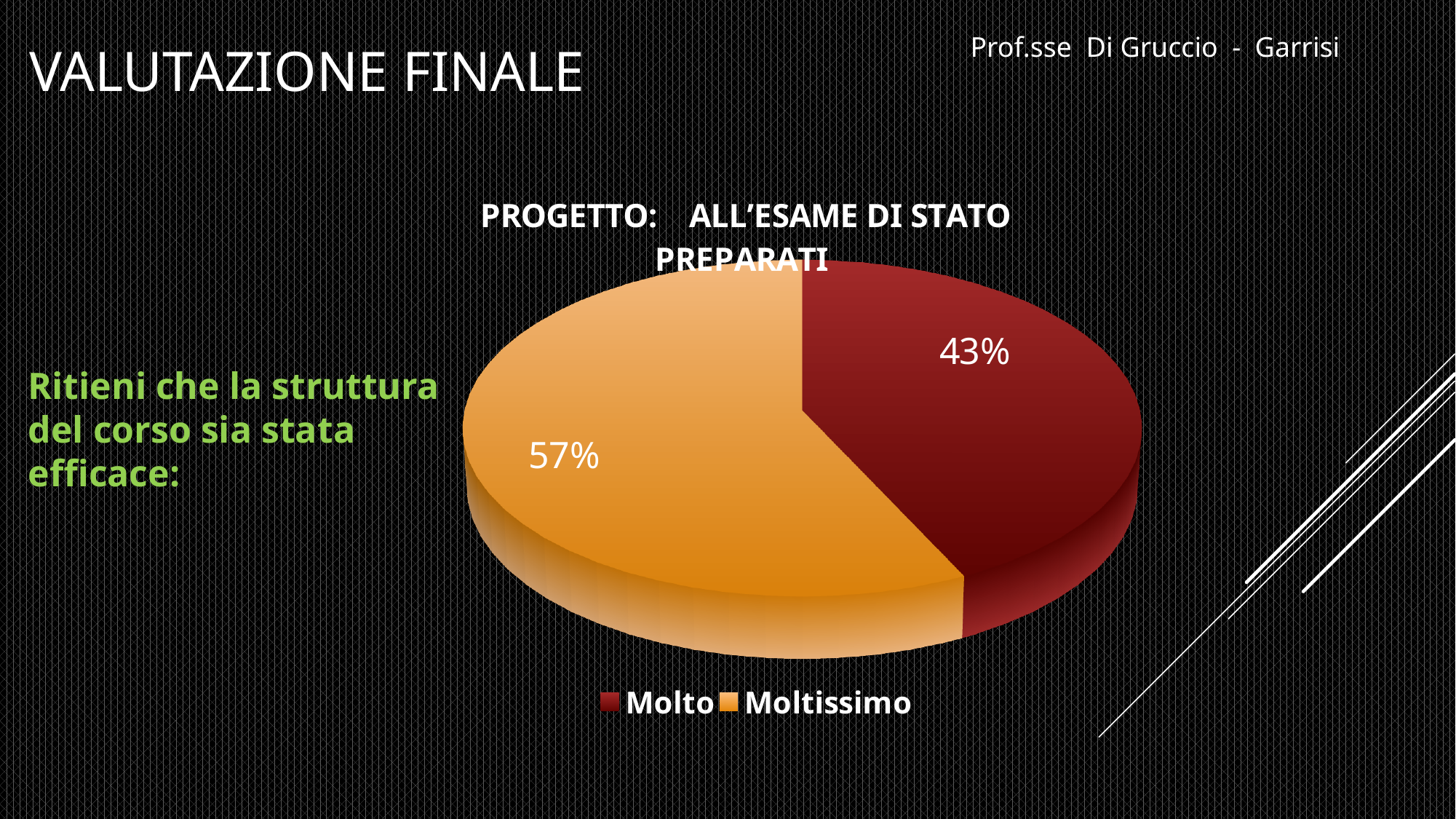
How many entries does the legend list? 2 What colour is the "Molto" slice in the pie chart? Dark red What kind of chart is shown on the slide? Pie chart Is the share for "Moltissimo" greater or less than 50%? greater Which slice is the smallest in the pie chart? Molto What percentage of the pie is labelled "Molto"? 43% What is the title of the chart? PROGETTO: ALL'ESAME DI STATO PREPARATI How many slices does the pie chart have? 2 Which slice is larger, "Molto" or "Moltissimo"? Moltissimo What is the difference in percentage points between the "Moltissimo" and "Molto" slices? 14 What percentage of the pie is labelled "Moltissimo"? 57% Which slice is the largest in the pie chart? Moltissimo